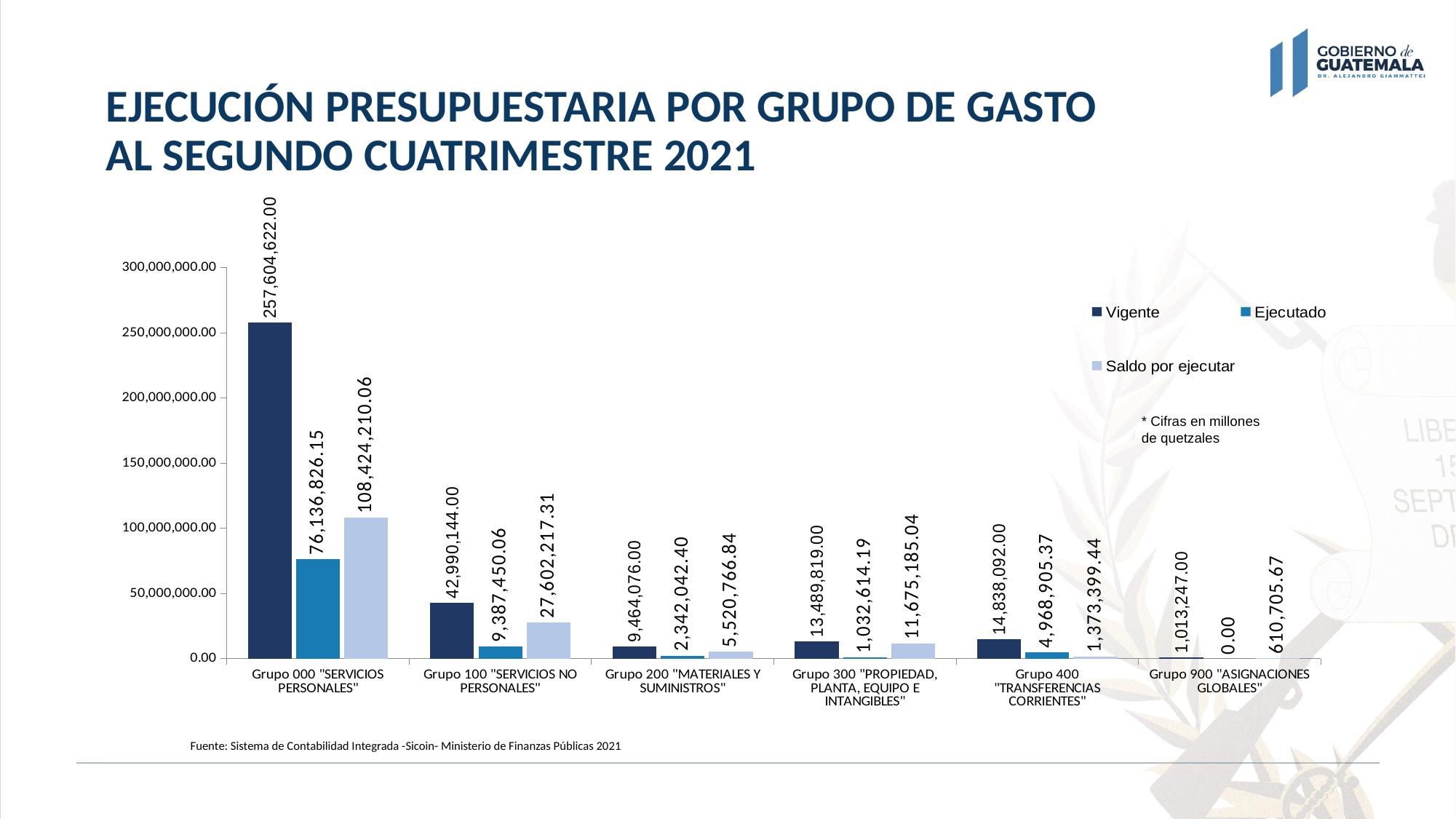
How many series does the legend list? 3 What type of chart is shown on the slide? Bar chart Which group has the lowest Vigente value? Grupo 900 "ASIGNACIONES GLOBALES" What is the Vigente value for Grupo 000 "SERVICIOS PERSONALES"? 257,604,622.00 How many expense groups (categories) are shown on the x axis? 6 Is the Saldo por ejecutar value for Grupo 000 "SERVICIOS PERSONALES" greater or less than 100,000,000.00? greater What is the difference between the Vigente values of Grupo 000 "SERVICIOS PERSONALES" and Grupo 100 "SERVICIOS NO PERSONALES"? 214,614,478.00 What is the Ejecutado value for Grupo 100 "SERVICIOS NO PERSONALES"? 9,387,450.06 Which group has the highest Vigente value? Grupo 000 "SERVICIOS PERSONALES" Which is larger for Grupo 400 "TRANSFERENCIAS CORRIENTES": the Ejecutado value or the Saldo por ejecutar value? Ejecutado What is the Ejecutado value for Grupo 900 "ASIGNACIONES GLOBALES"? 0.00 What is the Saldo por ejecutar value for Grupo 300 "PROPIEDAD, PLANTA, EQUIPO E INTANGIBLES"? 11,675,185.04